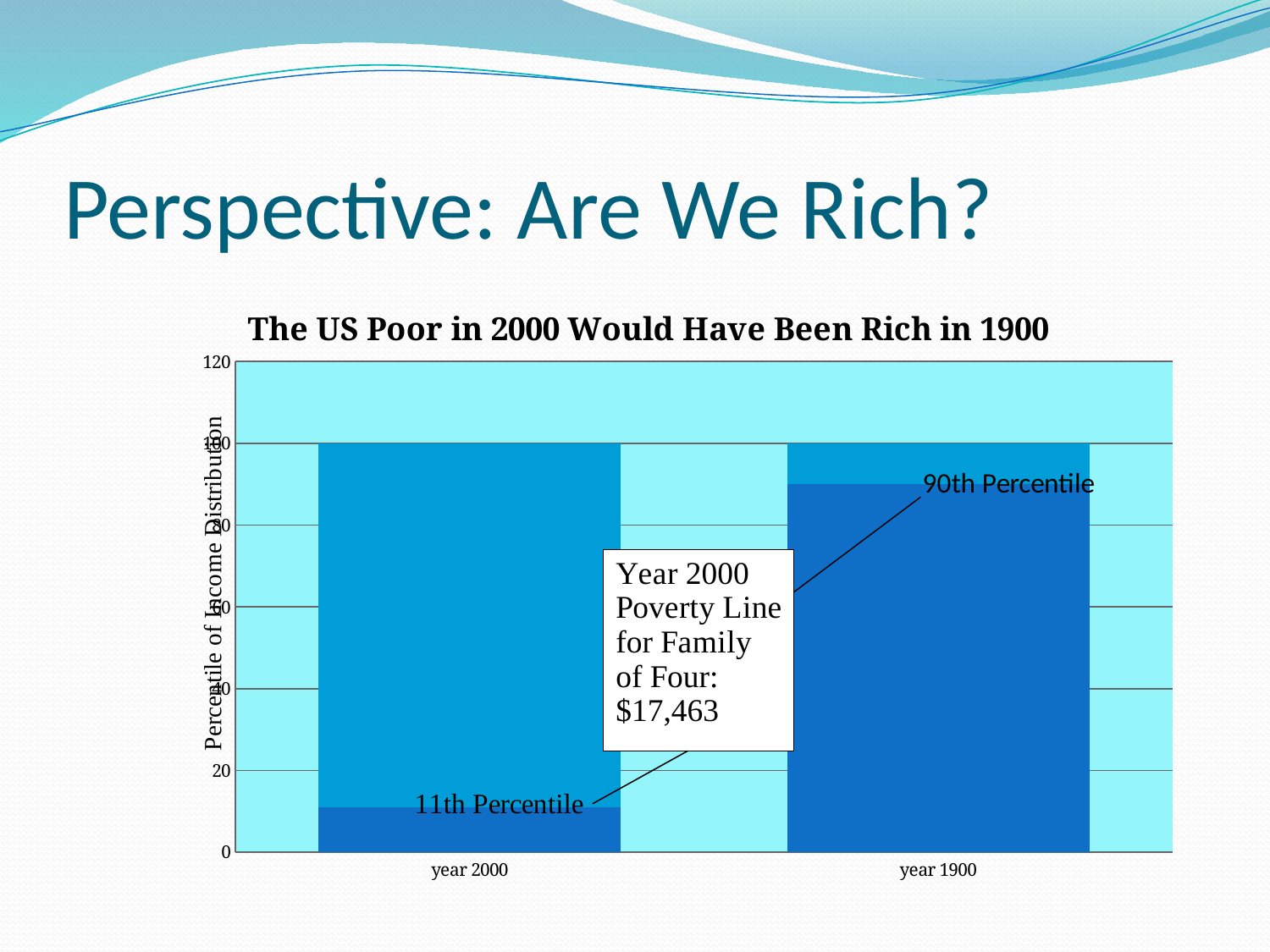
What is the title of the chart? The US Poor in 2000 Would Have Been Rich in 1900 Do the dark blue bar values rise or fall from year 2000 to year 1900 along the x axis? rise Which category has the higher dark blue bar, year 2000 or year 1900? year 1900 Is the dark blue value for year 1900 greater or less than 80? greater How many categories are shown on the x axis of the chart? 2 Which category has the lowest dark blue bar? year 2000 Which percentile label is attached to the dark blue bar for year 2000? 11th Percentile What is the maximum value shown on the y axis of the chart? 120 Which percentile label is attached to the dark blue bar for year 1900? 90th Percentile Is the dark blue value for year 2000 greater or less than 20? less What are the two categories on the x axis of the chart? year 2000 and year 1900 What kind of chart is shown on the slide? bar chart